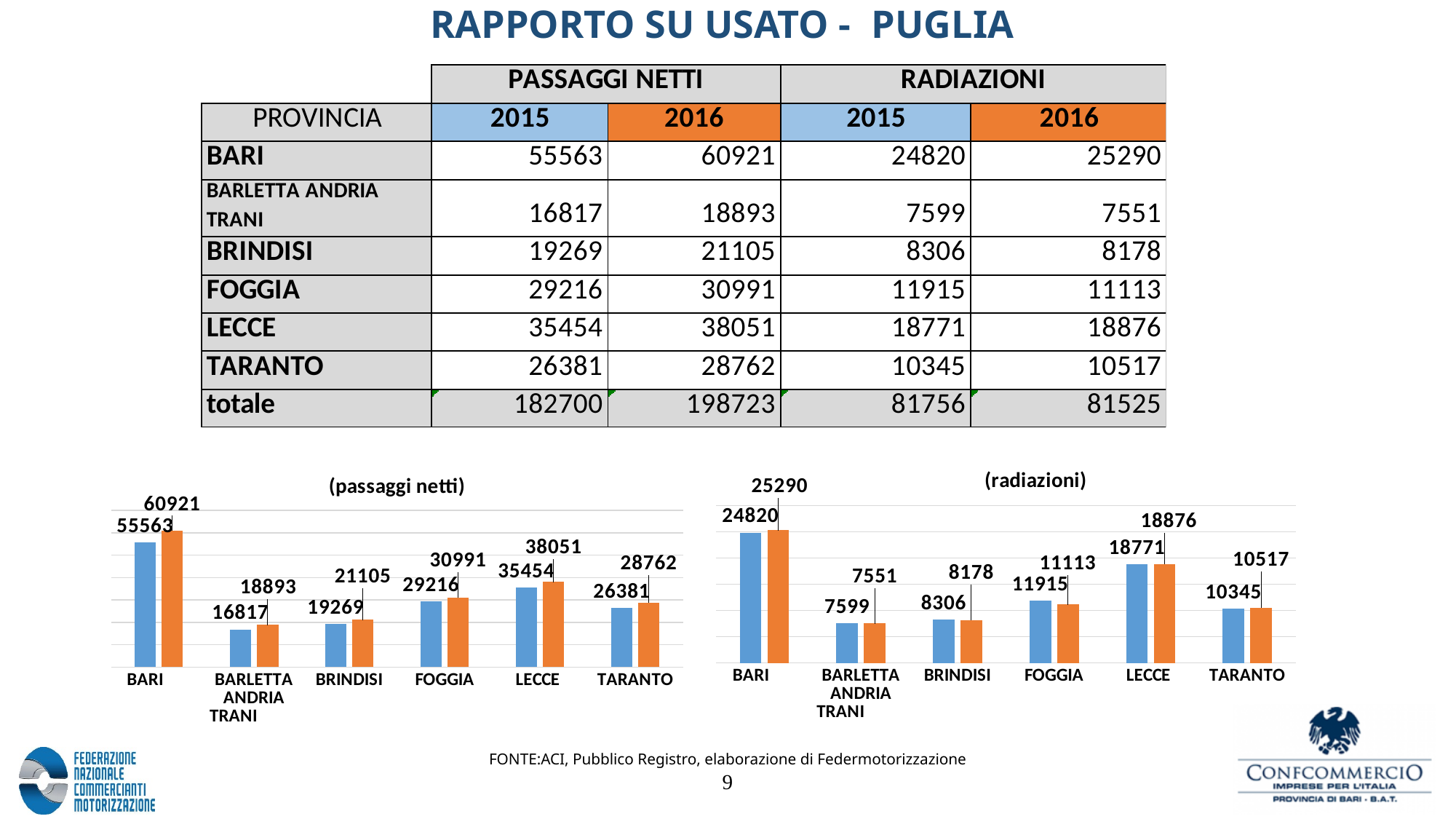
In the (passaggi netti) chart, what value is labelled on the orange (2016) bar for BARI? 60921 In the (radiazioni) chart, for BRINDISI, which bar is larger, the blue (2015) or the orange (2016)? blue (2015) How many provinces are shown on the x axis of the (passaggi netti) chart? 6 In the (radiazioni) chart, what is the difference between the blue (2015) and orange (2016) bars for FOGGIA? 802 In the (radiazioni) chart, which province has the lowest bar? BARLETTA ANDRIA TRANI What kind of chart is the (radiazioni) chart? bar chart In the (passaggi netti) chart, which orange (2016) bar is larger, LECCE or TARANTO? LECCE In the (passaggi netti) chart, which province has the highest bar? BARI In the (passaggi netti) chart, what is the difference between the orange (2016) and blue (2015) bars for BARI? 5358 In the (passaggi netti) chart, what value is labelled on the blue (2015) bar for TARANTO? 26381 In the (radiazioni) chart, what value is labelled on the blue (2015) bar for LECCE? 18771 In the (passaggi netti) chart, do the values rise or fall from BARI to BARLETTA ANDRIA TRANI? fall